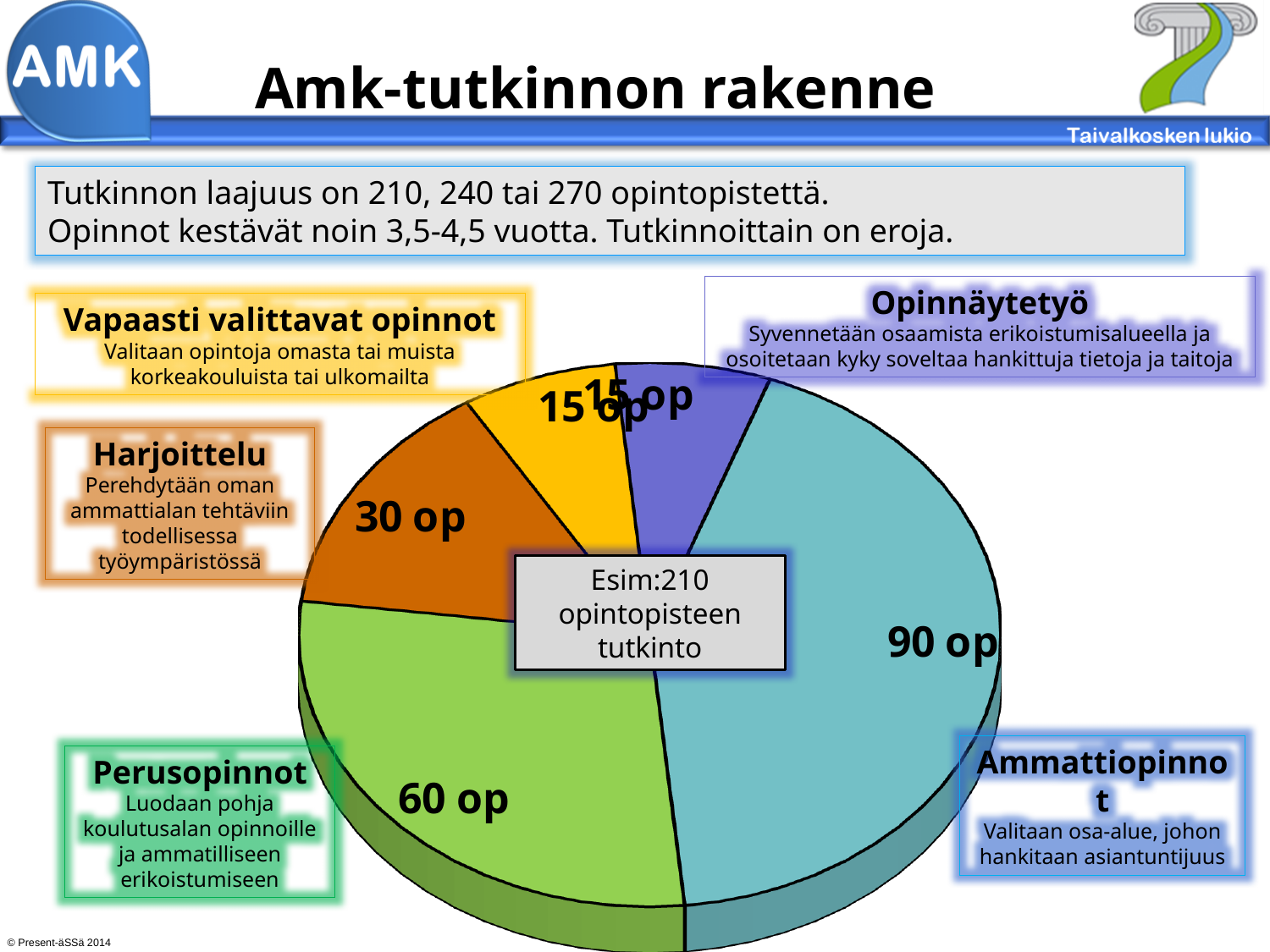
What value is shown on the Ammattiopinnot slice? 90 op What is the smallest value shown on any slice of the pie chart? 15 op What kind of chart is shown on the slide? pie chart Which slice of the pie chart is the largest? Ammattiopinnot (90 op) Which is larger, the Perusopinnot slice or the Harjoittelu slice? Perusopinnot What value is shown on the Opinnäytetyö slice? 15 op How many slices does the pie chart have? 5 What value is shown on the Perusopinnot slice? 60 op What colour is the Ammattiopinnot slice of the pie chart? teal (light blue) What is the difference between the Ammattiopinnot slice and the Perusopinnot slice? 30 op What value is shown on the Harjoittelu slice? 30 op What is the total number of credits represented by the whole pie chart? 210 opintopistettä